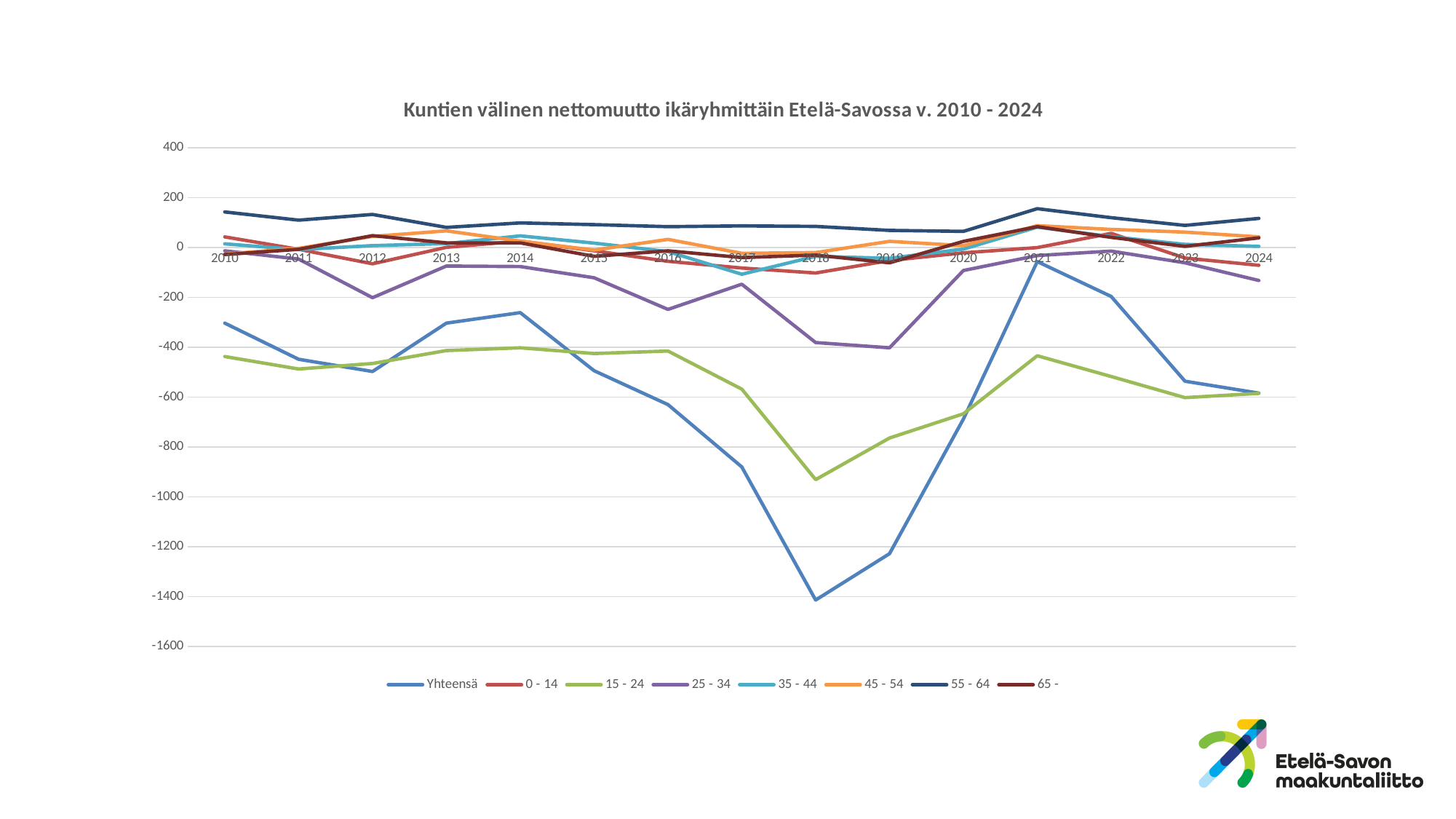
What kind of chart is shown on the slide? line chart What is the title of the chart? Kuntien välinen nettomuutto ikäryhmittäin Etelä-Savossa v. 2010 - 2024 How many series does the legend list? 8 In which year does the 15 - 24 series reach its lowest value? 2018 Does the Yhteensä series rise or fall from 2018 to 2021? rise Is the value for Yhteensä in 2018 greater or less than -1200? less Which is larger in 2021, the value for Yhteensä or the value for 15 - 24? Yhteensä Is the value for 55 - 64 in 2010 greater or less than 100? greater How many years are plotted along the x axis? 15 In which year does the Yhteensä series reach its lowest value? 2018 In which year does the Yhteensä series reach its highest value? 2021 Is the value for 15 - 24 in 2018 greater or less than -800? less